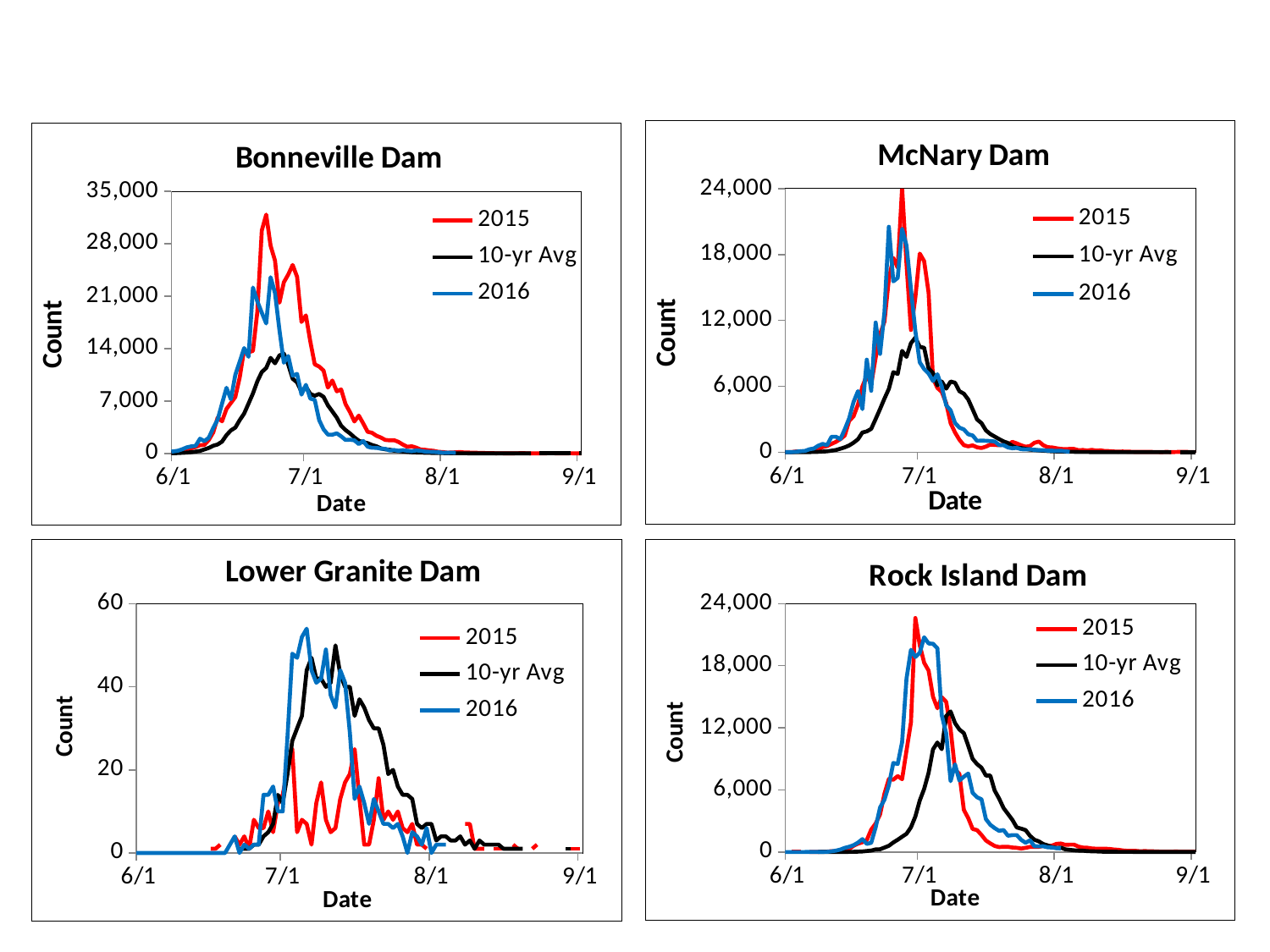
How many series does the legend of the Bonneville Dam chart list? 3 In the Bonneville Dam chart, which series reaches the highest peak? 2015 What kind of chart is the Bonneville Dam chart? line chart In the McNary Dam chart, which series has the lowest peak? 10-yr Avg In the McNary Dam chart, is the peak value of the 10-yr Avg series greater or less than 12,000? less In the Lower Granite Dam chart, which series has the lowest peak? 2015 In the Lower Granite Dam chart, is the peak value of the 2016 series greater or less than 40? greater In the Rock Island Dam chart, is the peak value of the 10-yr Avg series greater or less than 18,000? less In the Rock Island Dam chart, which series has the lowest peak? 10-yr Avg What is the x-axis title of the Lower Granite Dam chart? Date What are the three legend entries in the Rock Island Dam chart? 2015, 10-yr Avg, 2016